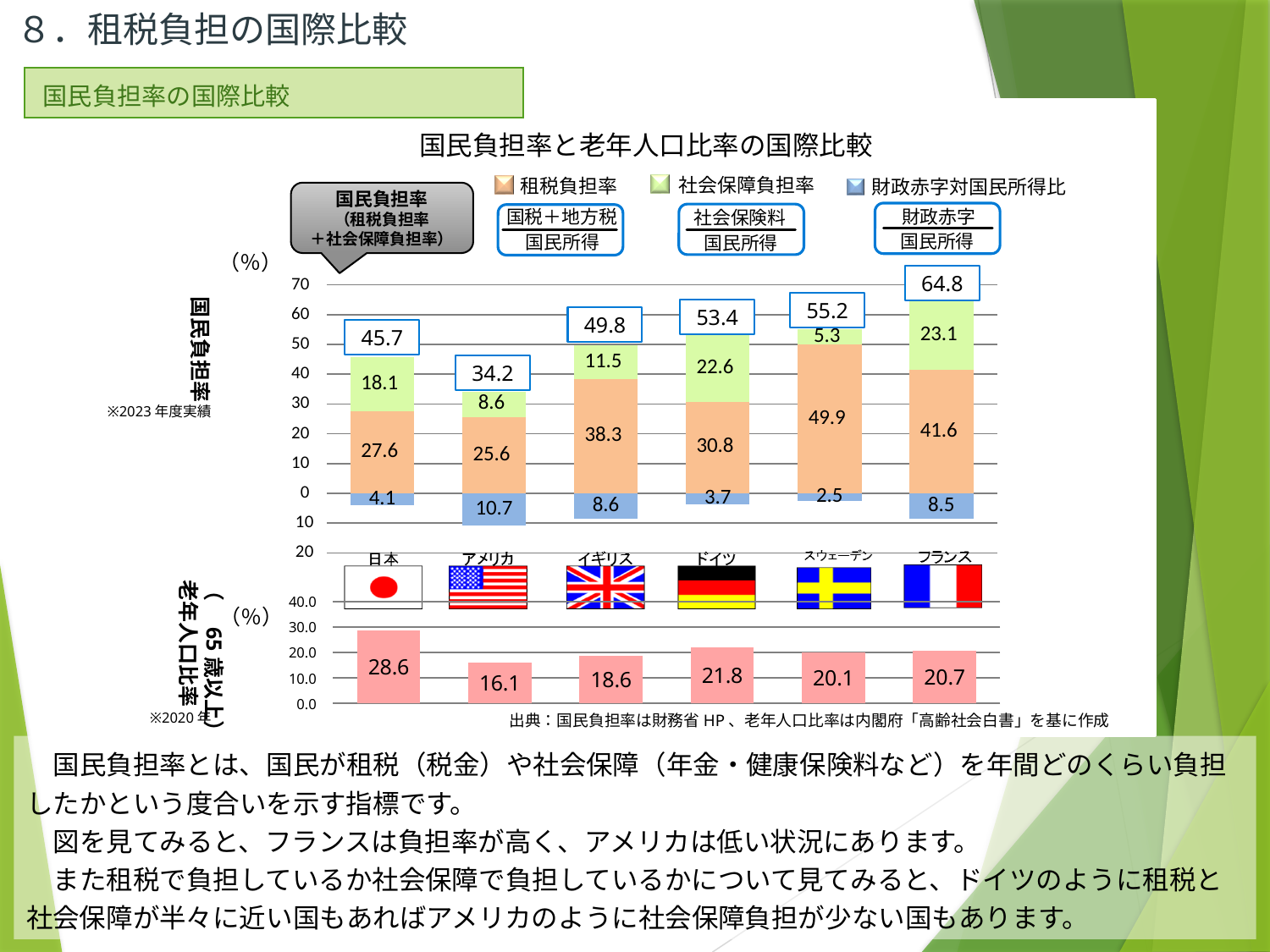
In the upper chart (国民負担率), how many series does the legend list? 3 In the upper chart (国民負担率), which is larger: the 社会保障負担率 of 日本 or that of イギリス? 日本 In the upper chart (国民負担率), what is the 社会保障負担率 value for ドイツ? 22.6 In the upper chart (国民負担率), which country has the highest 国民負担率 total? フランス In the lower chart (老年人口比率), what is the value for 日本? 28.6 In the lower chart (老年人口比率), which country has the lowest value? アメリカ What kind of chart is the lower chart (老年人口比率)? Bar chart In the upper chart (国民負担率), which country has the lowest 国民負担率 total? アメリカ In the lower chart (老年人口比率), how many countries are shown? 6 In the upper chart (国民負担率), what is the difference between the 租税負担率 of スウェーデン and that of 日本? 22.3 In the upper chart (国民負担率), what is the 財政赤字対国民所得比 value for アメリカ? 10.7 In the upper chart (国民負担率), what is the 租税負担率 value for フランス? 41.6